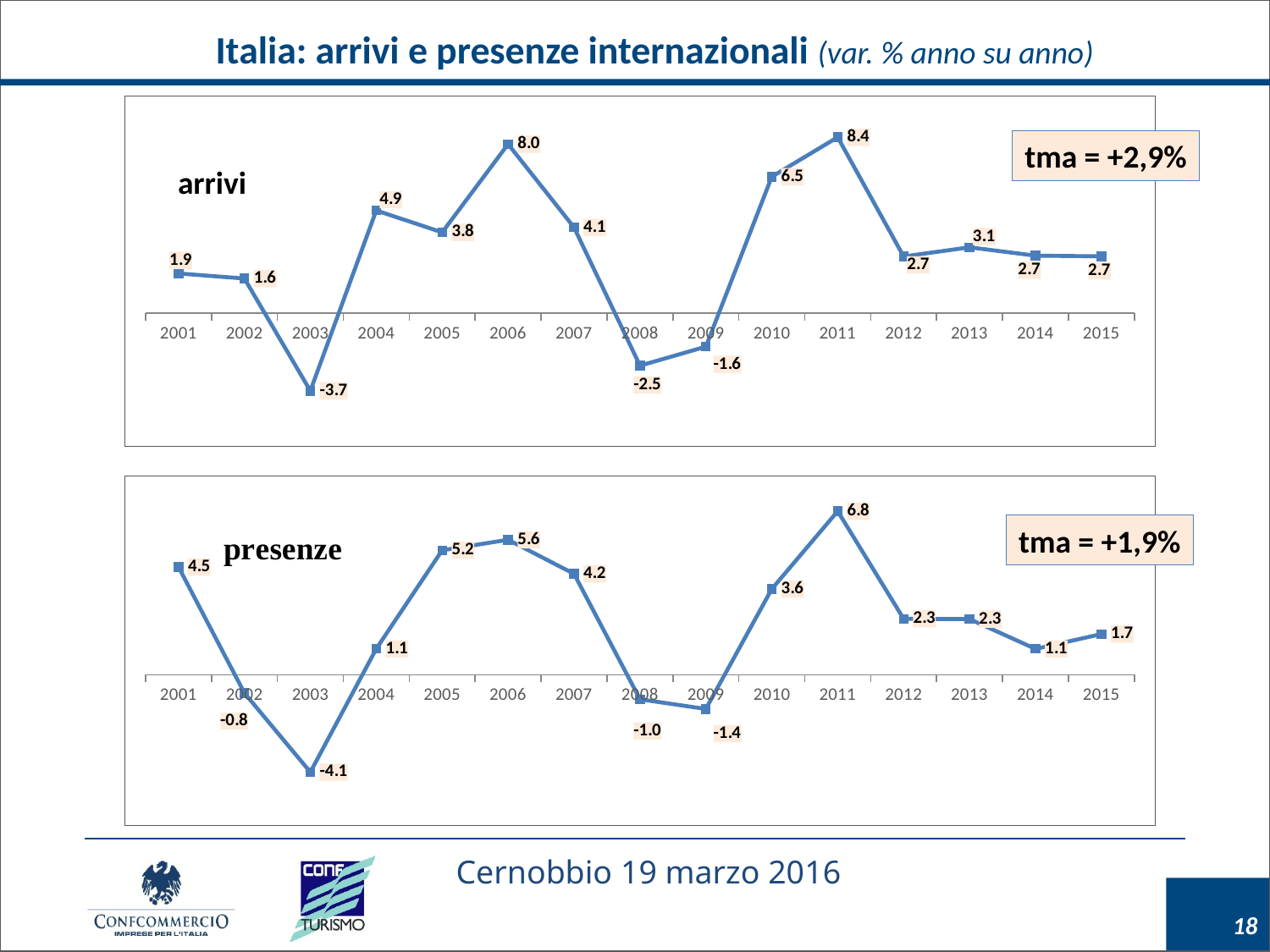
In the 'arrivi' chart (top), how many years are plotted? 15 In the 'arrivi' chart (top), what is the value for 2006? 8.0 In the 'presenze' chart (bottom), which year has the lowest value? 2003 In the 'arrivi' chart (top), which year has the highest value? 2011 In the 'presenze' chart (bottom), what is the difference between the values for 2001 and 2002? 5.3 In the 'presenze' chart (bottom), which is larger, the value for 2005 or the value for 2007? 2005 What kind of chart is the 'presenze' chart (bottom)? line chart What is the 'tma' value shown in the box on the 'arrivi' chart (top)? +2,9% In the 'arrivi' chart (top), what is the value for 2003? -3.7 In the 'presenze' chart (bottom), what is the value for 2011? 6.8 In the 'presenze' chart (bottom), do the values rise or fall from 2012 to 2014? fall In the 'arrivi' chart (top), what is the difference between the values for 2011 and 2010? 1.9